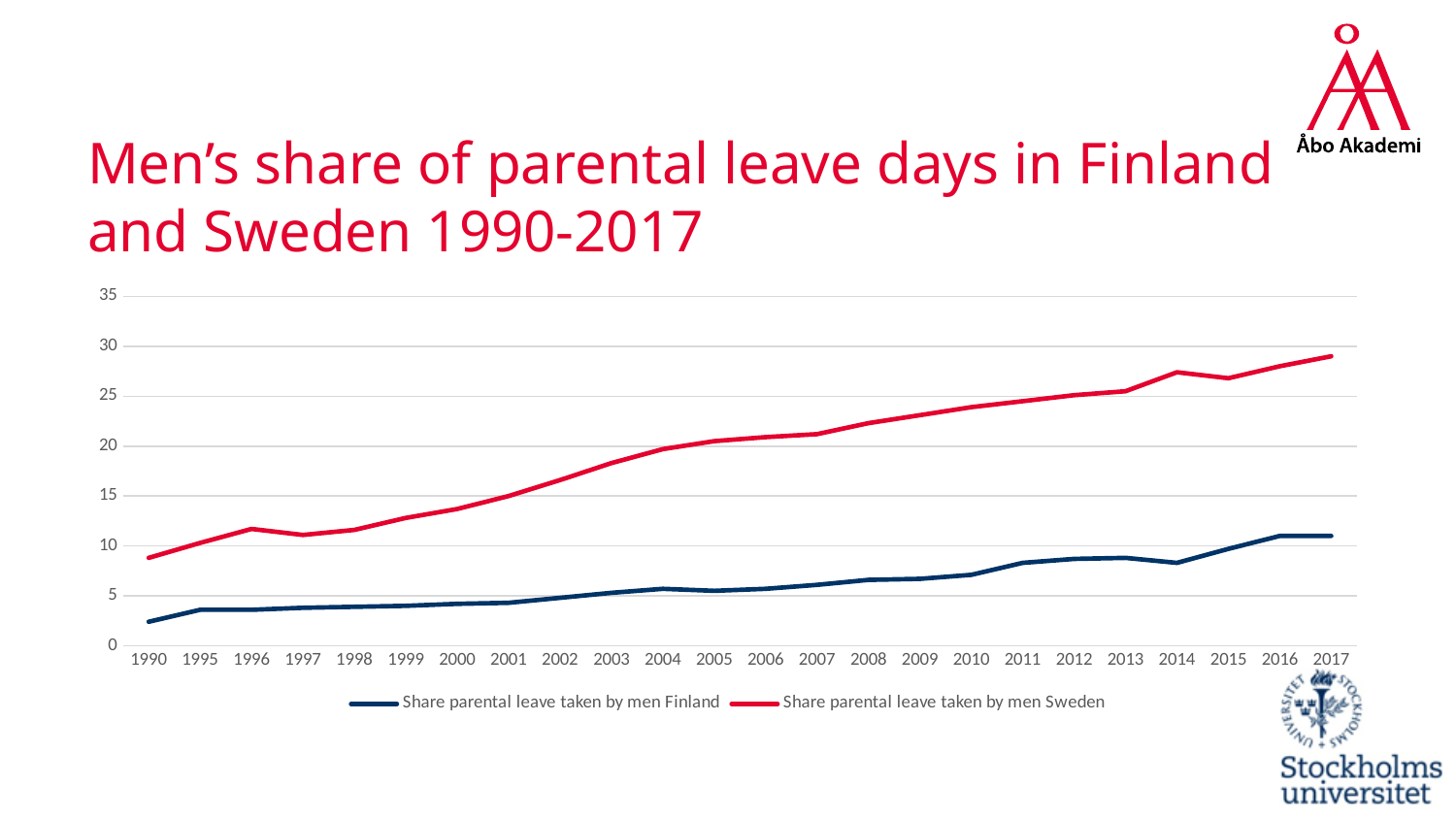
What kind of chart is shown on the slide? line chart In 2017, which country has the higher share of parental leave taken by men, Finland or Sweden? Sweden Is the value for Sweden in 2017 greater or less than 25? greater Which colour is the line for share of parental leave taken by men in Sweden? red In which year is the share of parental leave taken by men in Sweden highest? 2017 How many series does the legend list? 2 Is the value for Sweden in 1990 greater or less than 10? less Does the share of parental leave taken by men in Sweden generally rise or fall from 1990 to 2017? rise Is the value for Sweden in 2000 greater or less than 10? greater How many years are plotted along the x axis? 24